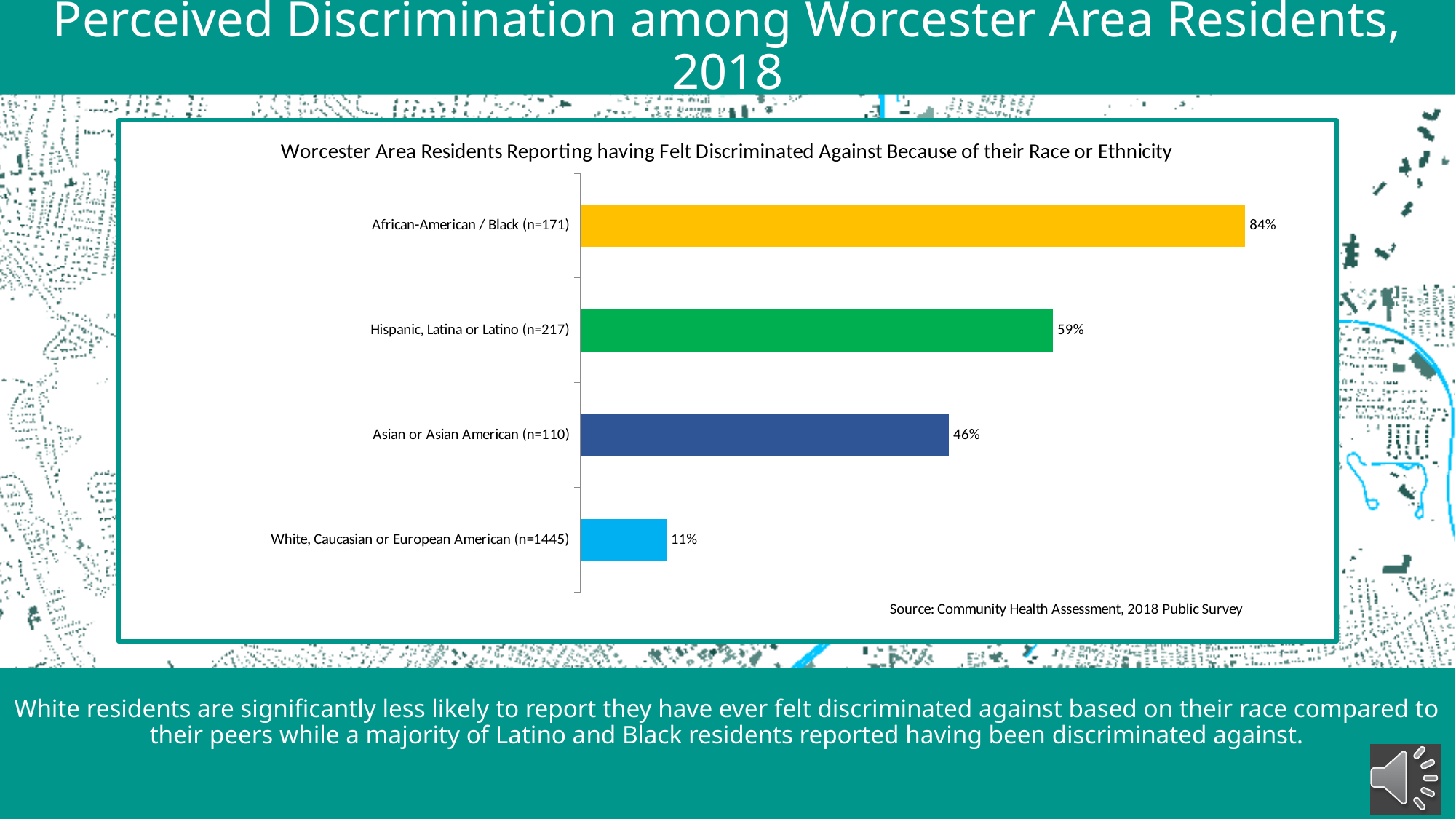
What type of chart is shown on the slide? Bar chart What percentage of Hispanic, Latina or Latino residents reported having felt discriminated against? 59% What is the difference in percentage points between the Hispanic, Latina or Latino group and the Asian or Asian American group? 13 What percentage of White, Caucasian or European American residents reported having felt discriminated against? 11% What percentage of Asian or Asian American residents reported having felt discriminated against? 46% How many groups are shown in the chart? 4 Which group has the highest percentage reporting having felt discriminated against? African-American / Black (n=171) Which group has the lowest percentage reporting having felt discriminated against? White, Caucasian or European American (n=1445) What percentage of African-American / Black residents reported having felt discriminated against because of their race or ethnicity? 84% What is the difference in percentage points between the African-American / Black group and the White, Caucasian or European American group? 73 Which group has a higher percentage: Hispanic, Latina or Latino or Asian or Asian American? Hispanic, Latina or Latino What is the sample size (n) shown for the White, Caucasian or European American group? 1445